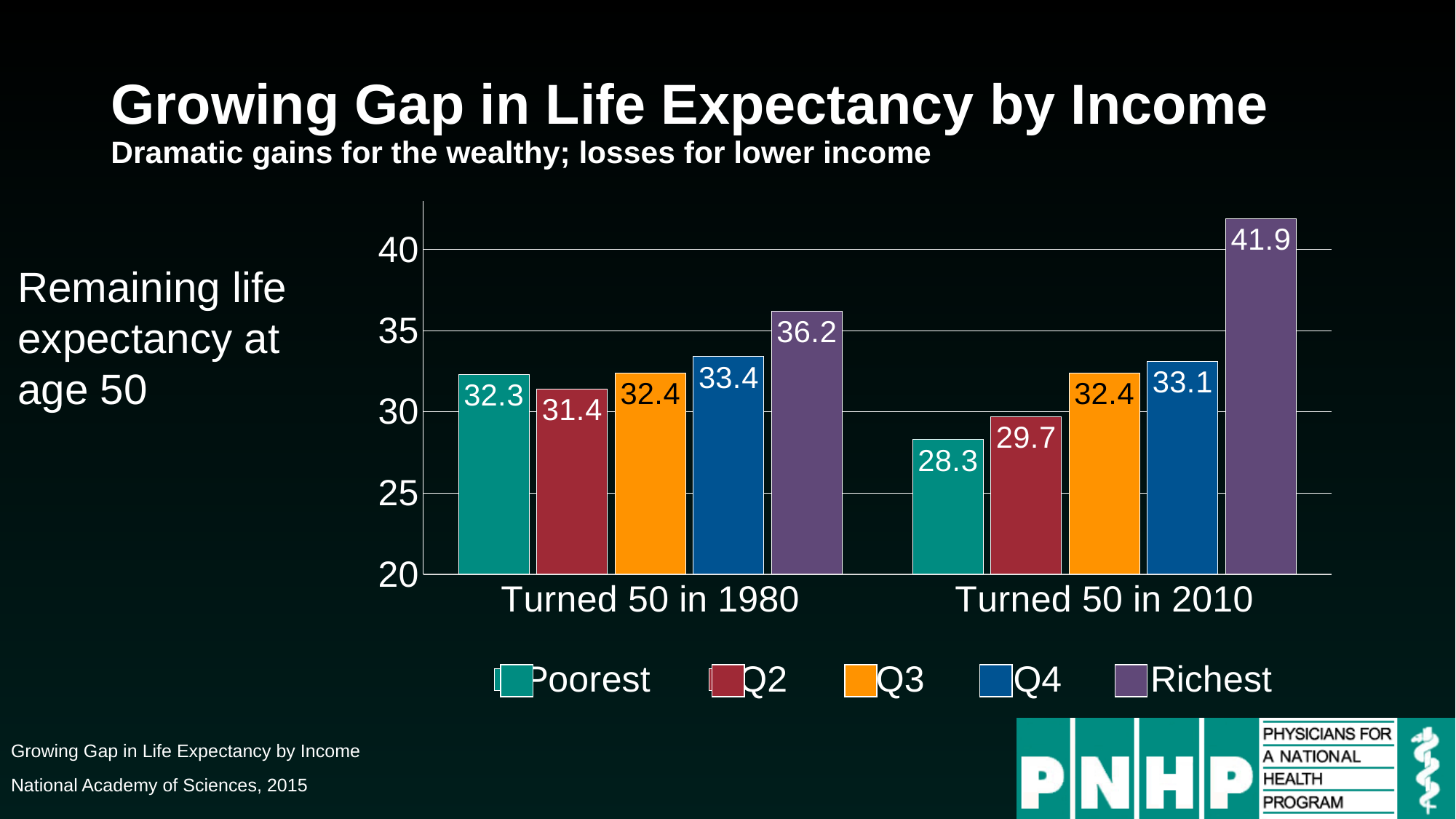
Which income group has the lowest value among those who turned 50 in 1980? Q2 Which is larger: the Poorest value for the 1980 cohort or the Poorest value for the 2010 cohort? Turned 50 in 1980 What colour represents the Q3 series in the chart? Orange What kind of chart is shown on the slide? Bar chart What is the value for the Poorest group who turned 50 in 1980? 32.3 What is the difference between the Richest and Poorest values for those who turned 50 in 2010? 13.6 Which income group has the highest value among those who turned 50 in 2010? Richest What is the value for Q2 in the 'Turned 50 in 2010' group? 29.7 What is the remaining life expectancy at age 50 for the Richest group who turned 50 in 2010? 41.9 How many series does the legend list? 5 Is the value for Q4 in the 'Turned 50 in 2010' group greater or less than 30? greater How much did the Richest group's value increase from the 1980 cohort to the 2010 cohort? 5.7